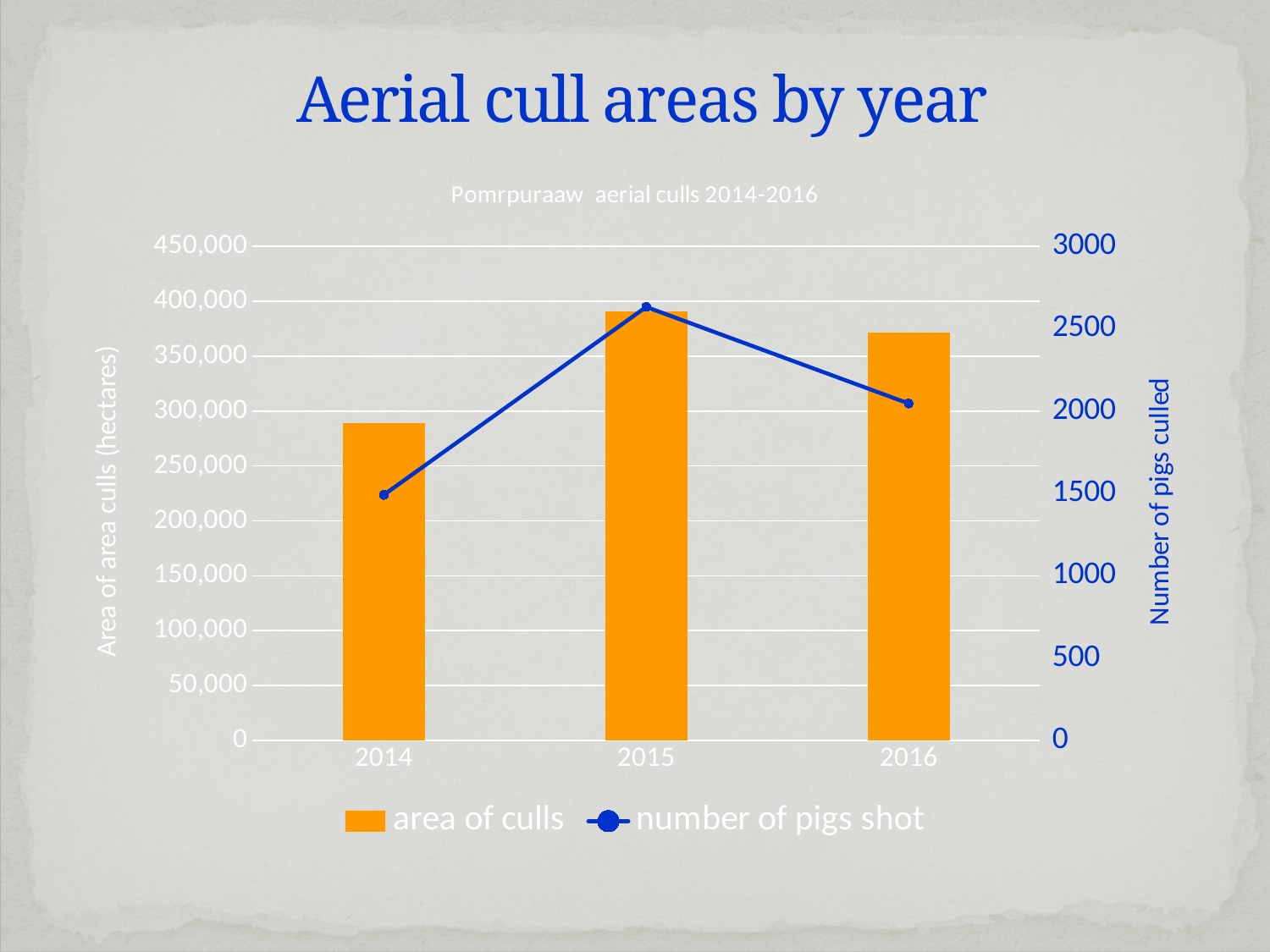
Which year has a larger area of culls, 2015 or 2016? 2015 Which year has the largest area of culls? 2015 Which year has the highest number of pigs shot? 2015 What is the subtitle printed above the chart? Pomrpuraaw aerial culls 2014-2016 Which year has the lowest number of pigs shot? 2014 Is the number of pigs shot in 2015 greater or less than 2500? greater Is the area of culls for 2014 greater or less than 300,000 hectares? less What type of chart is shown on the slide? A combination bar and line chart How many series does the chart legend list? 2 How many years are shown on the x axis of the chart? 3 Which year has the smallest area of culls? 2014 Is the area of culls for 2015 greater or less than 350,000 hectares? greater